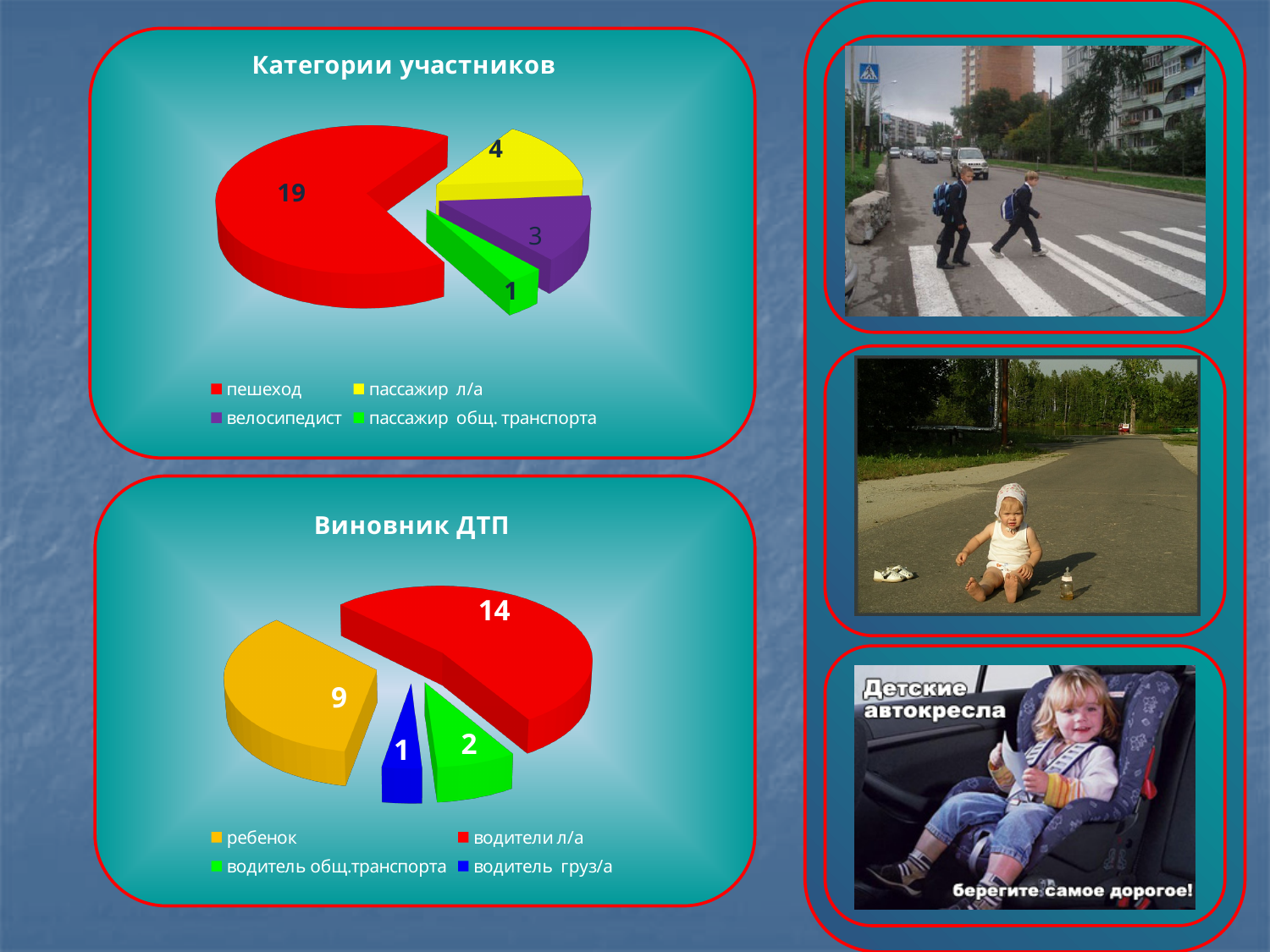
In the chart titled "Категории участников", how many categories does the legend list? 4 In the chart titled "Виновник ДТП", which category has the largest slice? водители л/а In the chart titled "Виновник ДТП", what colour is the slice for ребенок? yellow In the chart titled "Виновник ДТП", which is larger, водитель общ.транспорта or водитель груз/а? водитель общ.транспорта In the chart titled "Категории участников", what is the value for велосипедист? 3 In the chart titled "Виновник ДТП", what is the value for ребенок? 9 In the chart titled "Категории участников", what is the value for пешеход? 19 In the chart titled "Категории участников", what is the difference between the values for пешеход and пассажир л/а? 15 In the chart titled "Виновник ДТП", what is the value for водитель груз/а? 1 In the chart titled "Категории участников", which category has the smallest slice? пассажир общ. транспорта In the chart titled "Категории участников", which category has the largest slice? пешеход What type of chart is the chart titled "Виновник ДТП"? pie chart